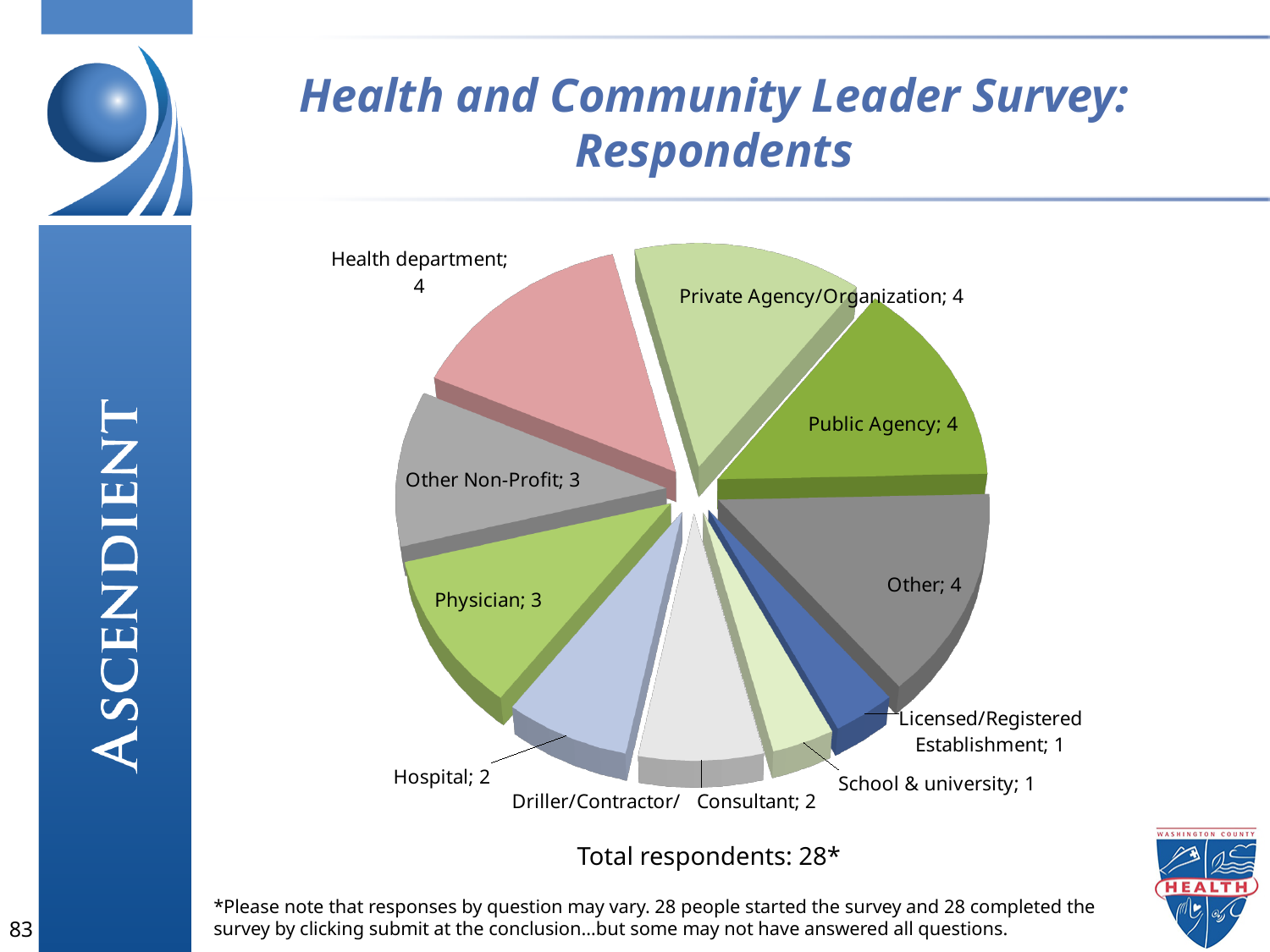
How many categories does the pie chart show? 10 How many respondents were from a School & university? 1 Which has more respondents, Other Non-Profit or Driller/Contractor/Consultant? Other Non-Profit How many respondents were from a Hospital? 2 How many respondents were Physicians? 3 What is the total number of respondents stated below the chart? 28 What kind of chart is shown on the slide? Pie chart What is the title of the slide containing the pie chart? Health and Community Leader Survey: Respondents How many respondents were from a Licensed/Registered Establishment? 1 What is the difference between the number of Public Agency respondents and Hospital respondents? 2 How many respondents were from a Health department? 4 What fraction of the 28 respondents were from the Other category? 4 out of 28